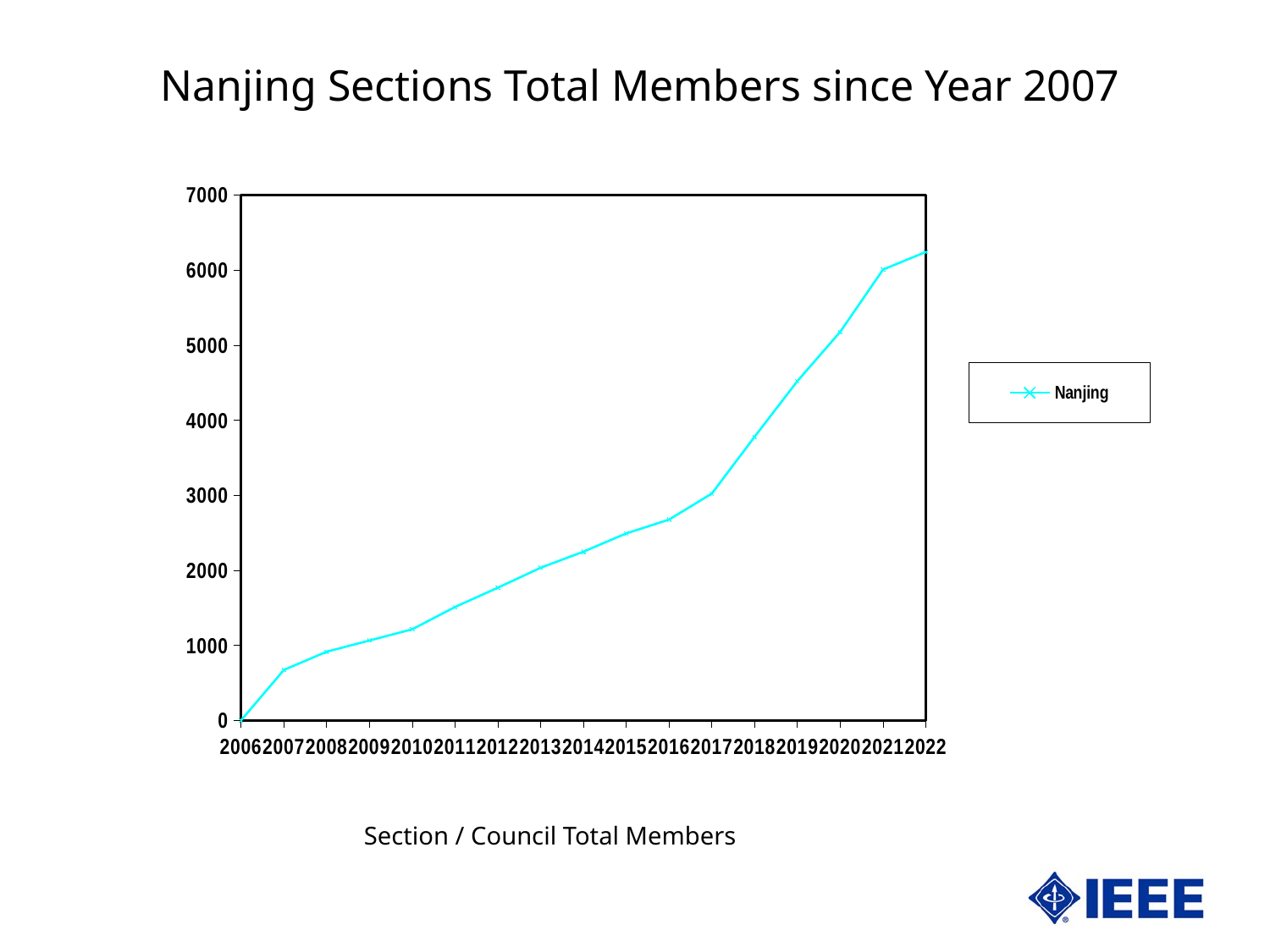
Is the value for Nanjing in 2018 greater or less than 4000? less Is the value for Nanjing in 2022 greater or less than 6000? greater Which year has the lowest value for Nanjing? 2006 How many series does the legend list? 1 Which year has the highest value for Nanjing? 2022 Do the values for Nanjing rise or fall from 2006 to 2022? rise Is the value for Nanjing in 2020 greater or less than 5000? greater What kind of chart is shown on the slide? line chart Which is larger, the value for Nanjing in 2015 or in 2020? 2020 What is the name of the series shown in the legend? Nanjing How many years are plotted along the x axis? 17